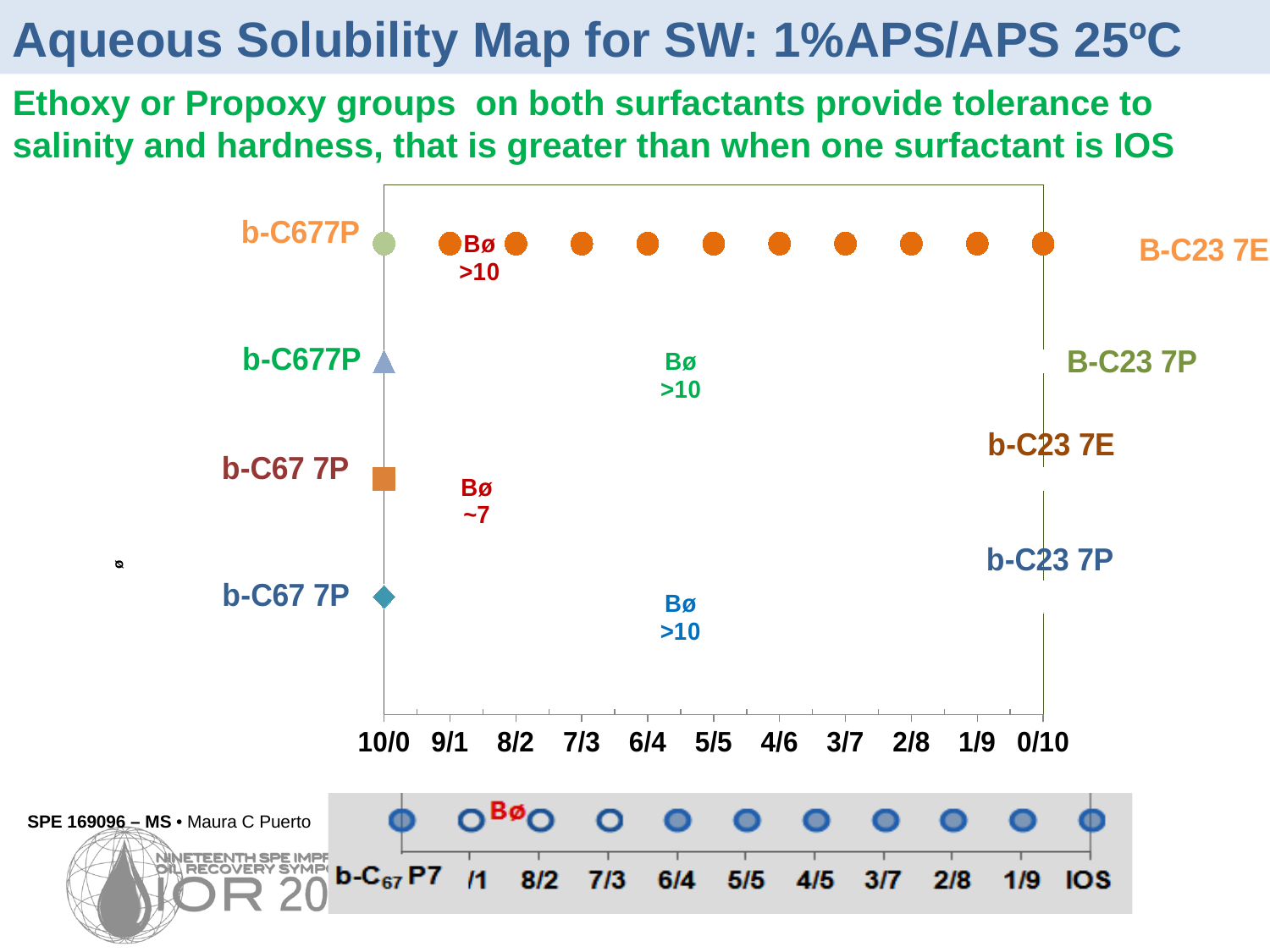
What is the last (rightmost) category label on the x axis? 0/10 What is the title of the chart on the slide? Aqueous Solubility Map for SW: 1%APS/APS 25ºC What Bø value is printed next to the top row of orange circles (b-C677P / B-C23 7E)? >10 Which row of the solubility map has markers plotted at every x-axis category? b-C677P / B-C23 7E (top row) What Bø value is printed next to the b-C677P row marked with a blue triangle (B-C23 7P)? >10 How many markers are plotted in the top row (b-C677P / B-C23 7E) of the solubility map? 11 What Bø value is printed next to the b-C67 7P row marked with a teal diamond (b-C23 7P)? >10 What kind of chart is the solubility map? Scatter chart How many categories are labelled along the x axis of the solubility map? 11 What is the first (leftmost) category label on the x axis? 10/0 What is the x-axis label at the middle position of the solubility map? 5/5 What Bø value is printed next to the b-C67 7P row marked with an orange square? ~7